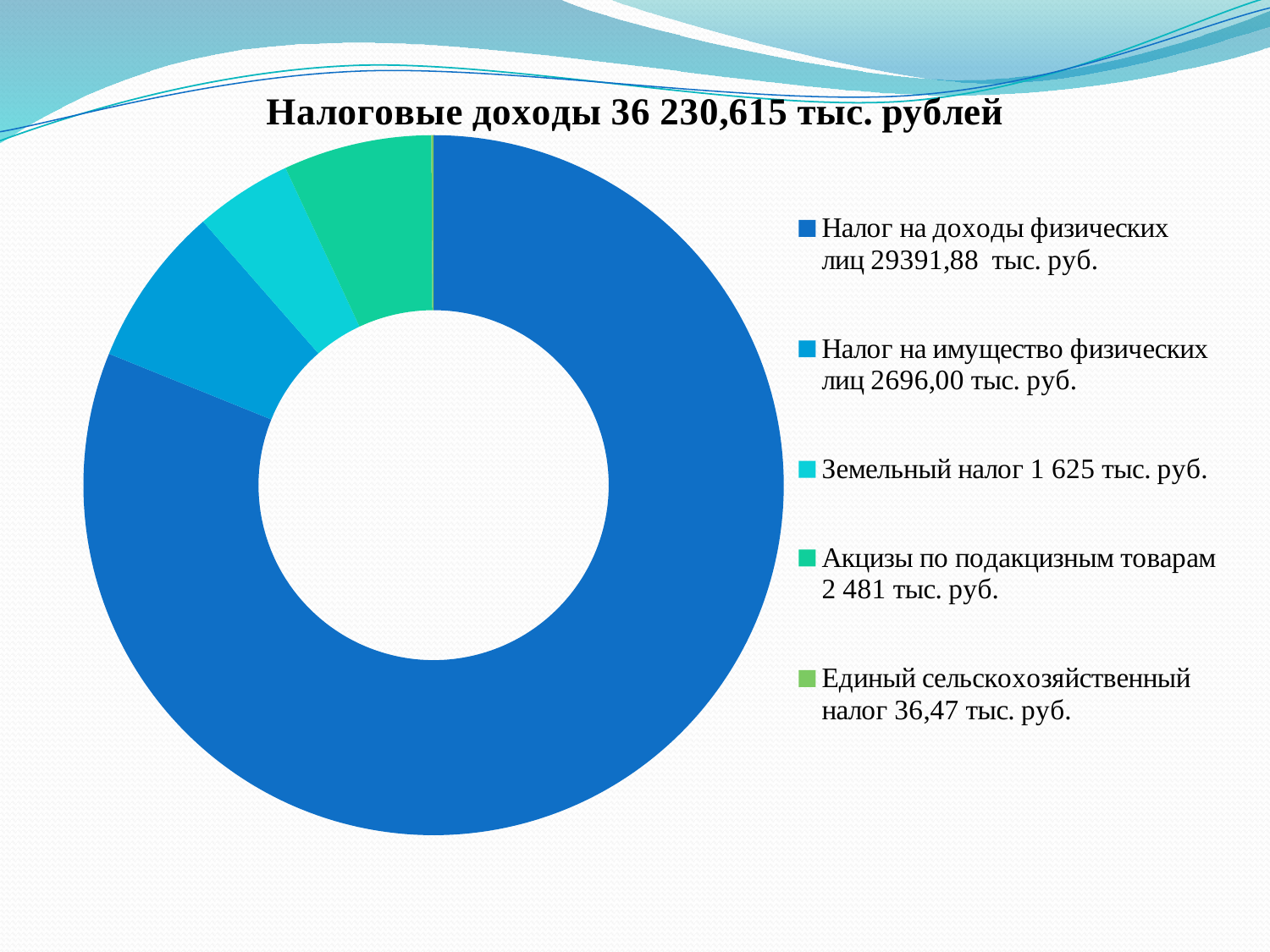
What is the difference between Акцизы по подакцизным товарам and Земельный налог? 856 тыс. руб. Which is larger: Налог на имущество физических лиц or Акцизы по подакцизным товарам? Налог на имущество физических лиц What is the value for Налог на имущество физических лиц? 2696,00 тыс. руб. What kind of chart is shown on the slide? doughnut chart What is the value for Акцизы по подакцизным товарам? 2 481 тыс. руб. Which category has the largest value? Налог на доходы физических лиц What is the value for Земельный налог? 1 625 тыс. руб. What is the value for Единый сельскохозяйственный налог? 36,47 тыс. руб. What is the title of the chart? Налоговые доходы 36 230,615 тыс. рублей How many categories does the chart show? 5 What is the value for Налог на доходы физических лиц? 29391,88 тыс. руб. Which category has the smallest value? Единый сельскохозяйственный налог